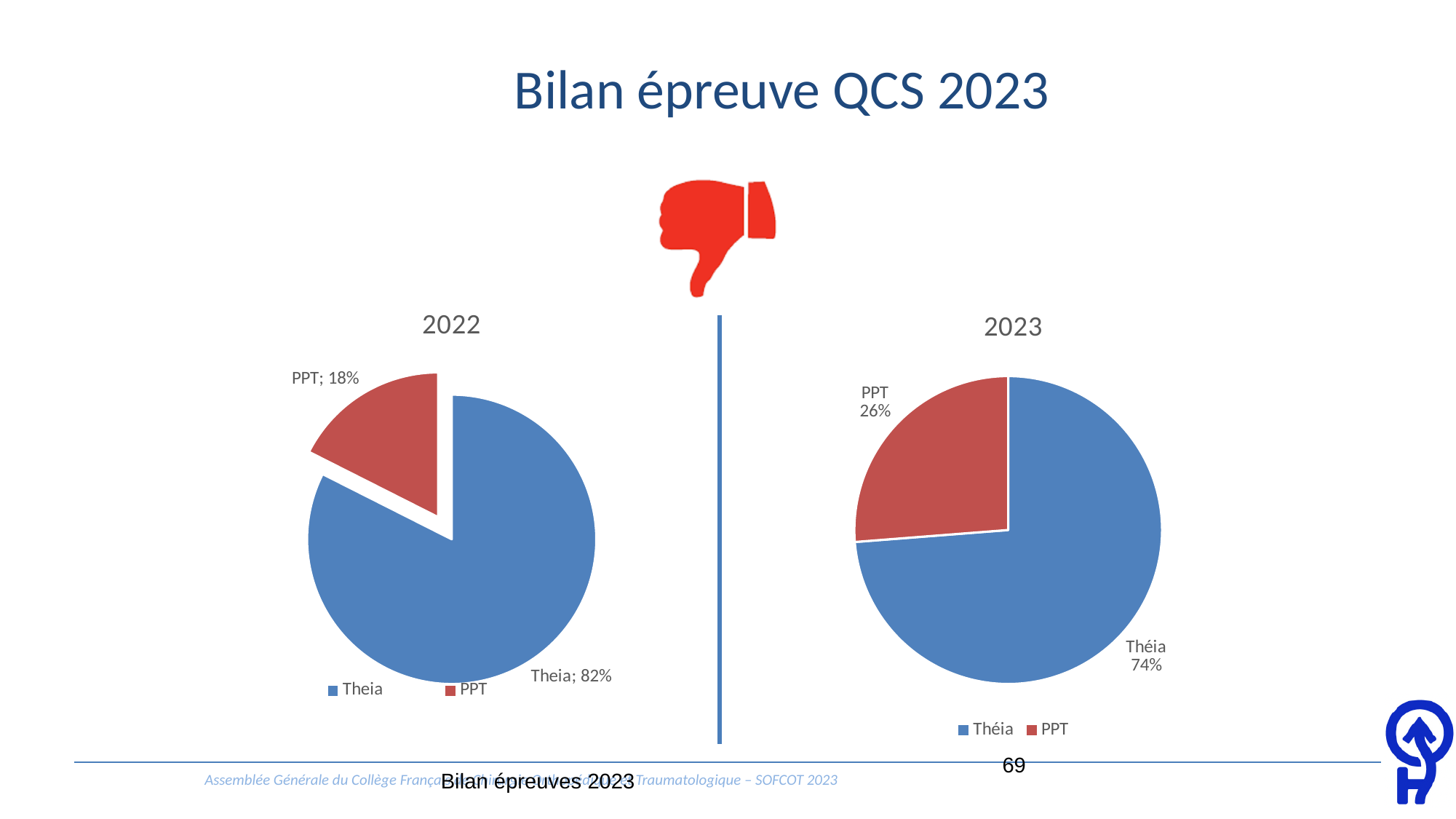
In the 2023 chart, what is the difference between the Théia and PPT shares? 48% What kind of chart is the 2023 chart? Pie chart In the 2023 chart, what share does PPT have? 26% In the 2022 chart, what share does PPT have? 18% In the 2022 chart, what is the difference between the Theia and PPT shares? 64% In the 2023 chart, which slice is the smallest? PPT In the 2023 chart, what share does Théia have? 74% In the 2022 chart, which slice is the largest? Theia How many slices does the 2022 chart have? 2 In the 2022 chart, what share does Theia have? 82% In the 2023 chart, what colour is the PPT slice? Red Is the PPT share larger in the 2022 chart or the 2023 chart? 2023